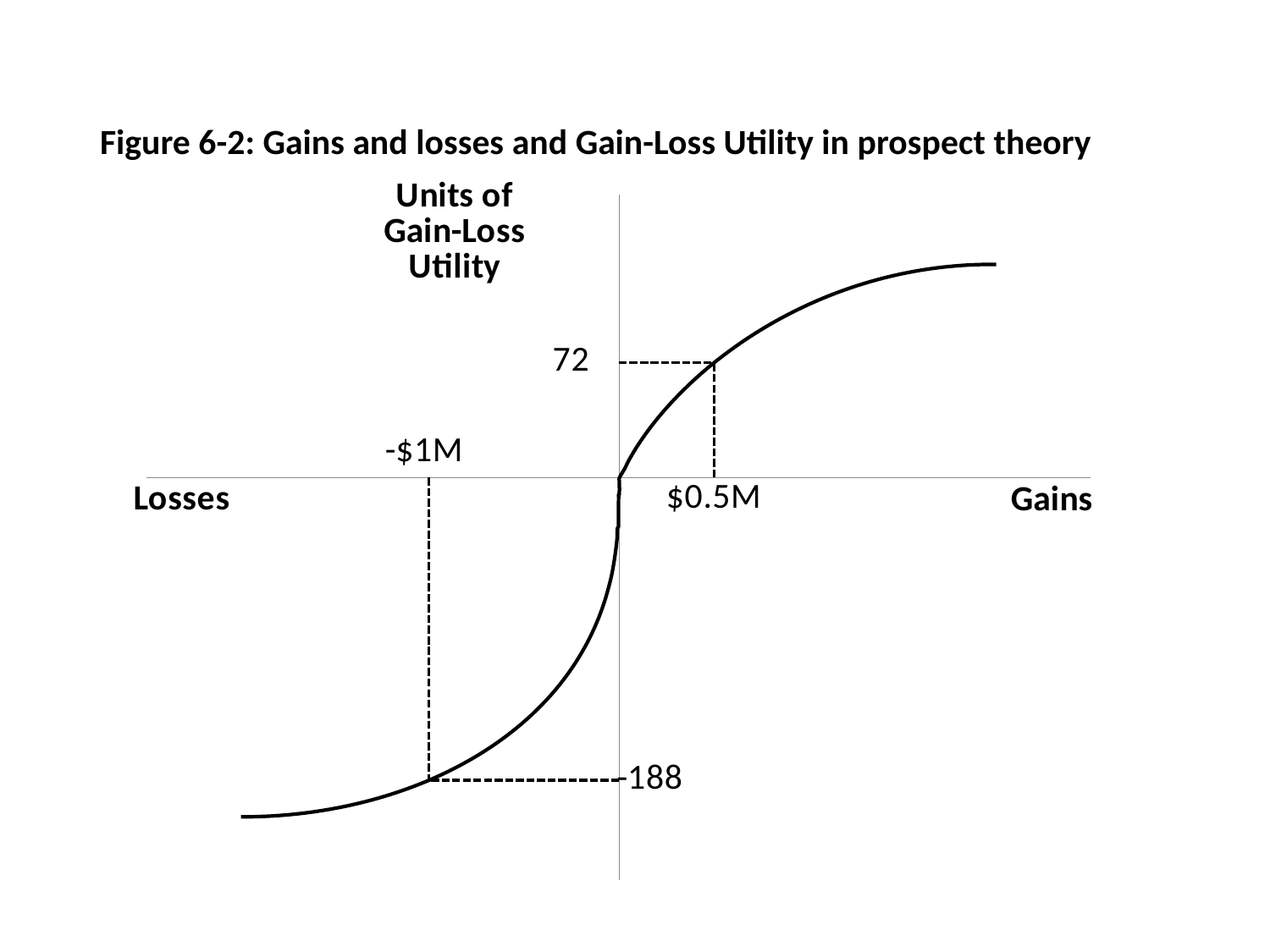
What is the gain-loss utility value marked for a loss of -$1M? -188 What is the difference between the absolute utility of the -$1M loss (188) and the utility of the $0.5M gain (72)? 116 How many points on the curve are marked with dashed lines and labeled values? 2 What is the label on the vertical axis? Units of Gain-Loss Utility What is the gain-loss utility value marked for a gain of $0.5M? 72 Does the curve rise or fall as you move from losses to gains along the x axis? Rises What kind of chart is shown on the slide? Line chart Which has the larger absolute utility value: the loss of -$1M or the gain of $0.5M? The loss of -$1M What is the title of the figure? Figure 6-2: Gains and losses and Gain-Loss Utility in prospect theory Is the utility value for the -$1M loss positive or negative? Negative